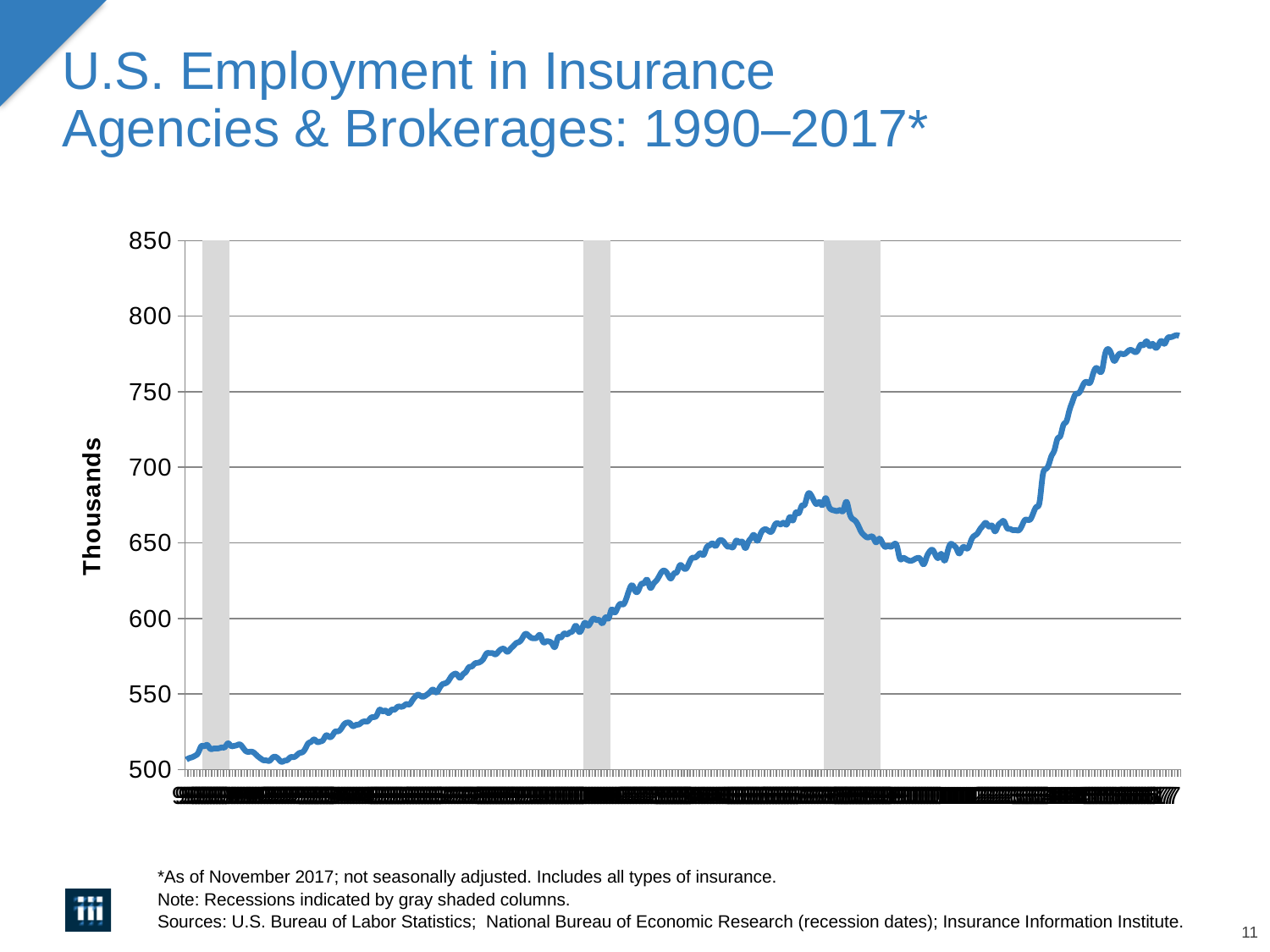
Is the value at the start of the line (1990) greater or less than 550? less Is the lowest point on the line greater or less than 550? less Which is larger, the value at the start of the series or the value at the end of the series? The end of the series Where along the x axis does the line reach its highest value? At the end (2017) What is the label on the vertical axis? Thousands How many gray shaded recession columns are shown on the chart? 3 Overall, does employment rise or fall from 1990 to 2017? Rise What is the title of the chart? U.S. Employment in Insurance Agencies & Brokerages: 1990–2017* Is the value at the end of the line (2017) greater or less than 750? greater What kind of chart is shown on the slide? Line chart What are the lowest and highest values shown on the vertical axis? 500 and 850